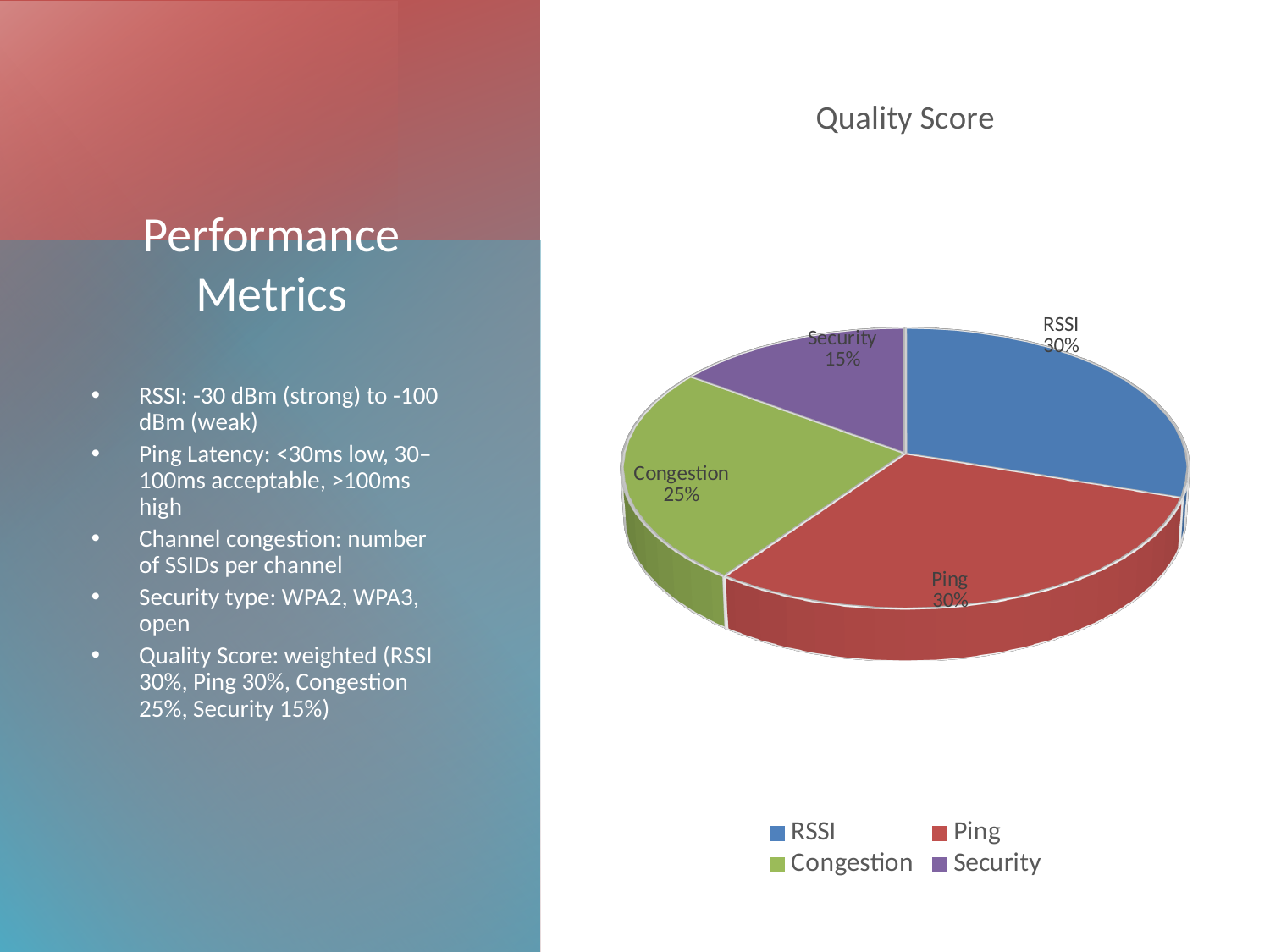
What share of the pie does Congestion have? 25% What colour is the Congestion slice? green How many slices does the pie chart have? 4 What share of the pie does Security have? 15% What kind of chart is shown on the slide? pie chart What is the title of the chart? Quality Score What share of the pie does RSSI have? 30% How many entries does the legend list? 4 Which is larger, the Ping slice or the Congestion slice? Ping What is the combined share of RSSI and Ping? 60% Which slice of the pie is the smallest? Security What is the difference between the Congestion share and the Security share? 10%